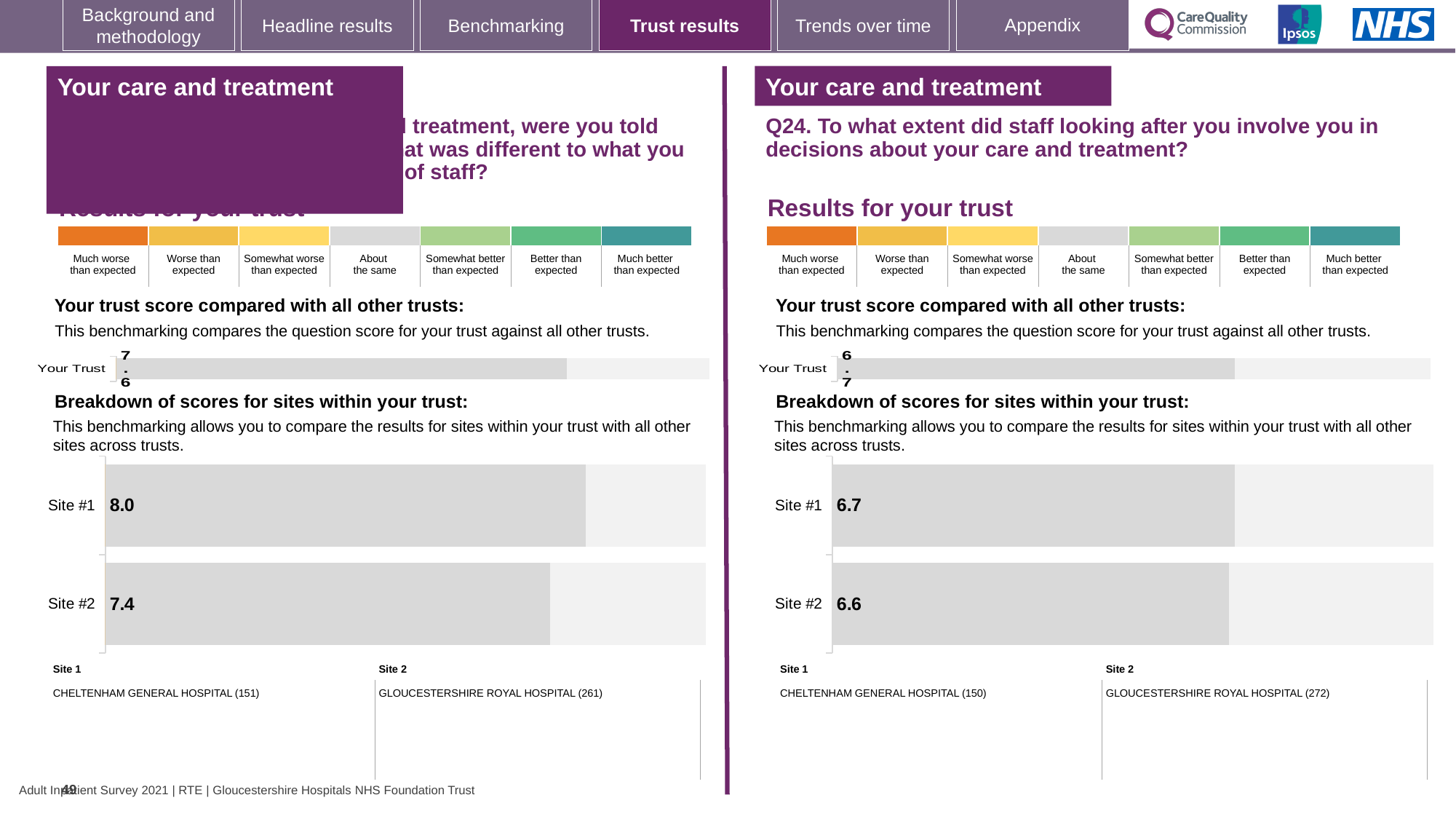
What kind of chart is used for the breakdown of scores for sites on the left-hand panel? Bar chart On the right-hand panel (Q24), what is the difference between the Site #1 and Site #2 scores? 0.1 On the left-hand panel, what is the difference between the Site #1 and Site #2 scores? 0.6 On the left-hand panel, what is the 'Your Trust' score in the trust score comparison bar? 7.6 On the right-hand panel (Q24), which hospital is listed as Site 2? GLOUCESTERSHIRE ROYAL HOSPITAL (272) How many sites are shown in the site breakdown chart on the right-hand panel (Q24)? 2 On the right-hand panel (Q24), what is the 'Your Trust' score in the trust score comparison bar? 6.7 On the right-hand panel (Q24), what is the score shown for Site #1? 6.7 On the right-hand panel (Q24), what is the score shown for Site #2? 6.6 On the left-hand panel, which site has the higher score in the site breakdown? Site #1 On the left-hand panel, what is the score shown for Site #1 in the breakdown of scores for sites within your trust? 8.0 On the left-hand panel, what is the score shown for Site #2 in the breakdown of scores for sites within your trust? 7.4